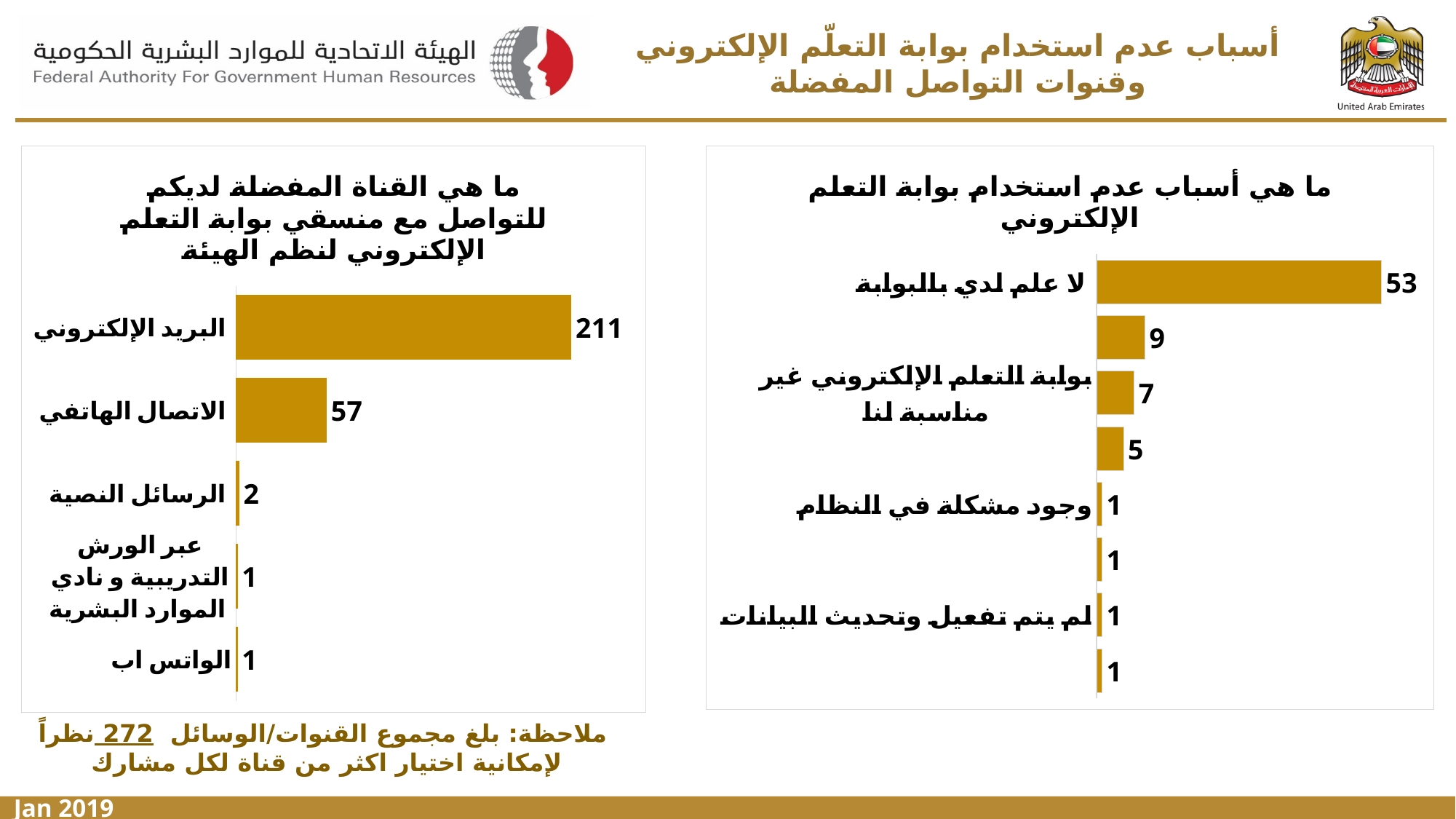
In the left chart (preferred communication channel), what is the value for البريد الإلكتروني? 211 In the left chart (preferred communication channel), what is the value for الاتصال الهاتفي? 57 In the left chart (preferred communication channel), what is the value for الرسائل النصية? 2 In the right chart (reasons for not using the e-learning portal), what is the value for بوابة التعلم الإلكتروني غير مناسبة لنا? 7 In the right chart (reasons for not using the e-learning portal), what is the value for لا علم لدي بالبوابة? 53 In the right chart (reasons for not using the e-learning portal), which category has the highest value? لا علم لدي بالبوابة In the right chart (reasons for not using the e-learning portal), how many bars are plotted? 8 In the left chart (preferred communication channel), what is the difference between البريد الإلكتروني and الاتصال الهاتفي? 154 What type of chart is the left chart (preferred communication channel)? Bar chart In the left chart (preferred communication channel), which category has the highest value? البريد الإلكتروني In the left chart (preferred communication channel), how many categories are shown? 5 In the right chart (reasons for not using the e-learning portal), which is larger: لا علم لدي بالبوابة or وجود مشكلة في النظام? لا علم لدي بالبوابة